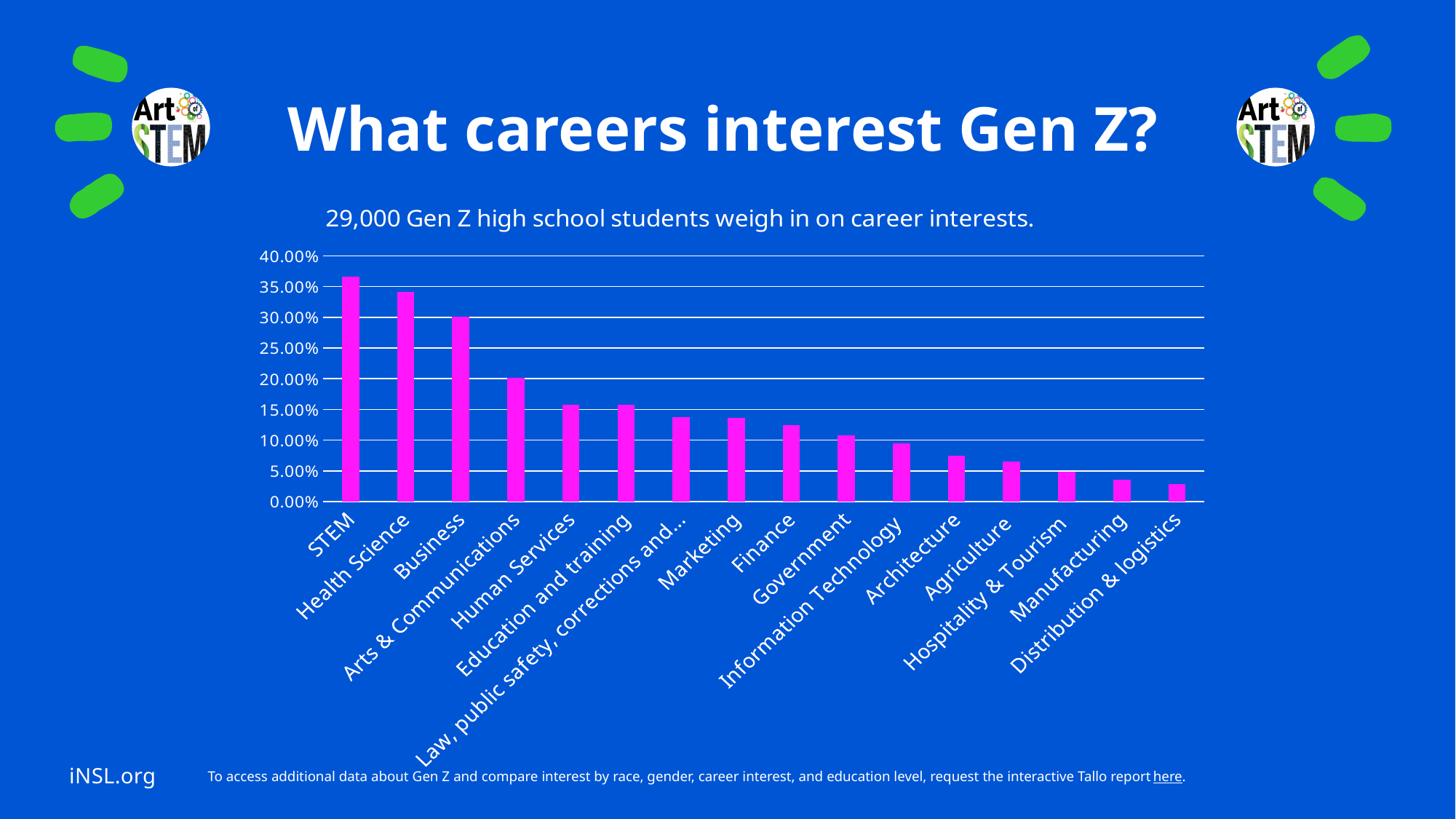
How many career categories are shown on the chart? 16 What kind of chart is shown on the slide? bar chart Do the values rise or fall moving from left to right across the categories? fall Which career category has the lowest value? Distribution & logistics Is the value for Architecture greater or less than 10.00%? less Which has a higher value, Business or Arts & Communications? Business Is the value for Health Science greater or less than 30.00%? greater What is the subtitle shown above the chart? 29,000 Gen Z high school students weigh in on career interests. Is the value for STEM greater or less than 35.00%? greater Which career category has the highest value? STEM